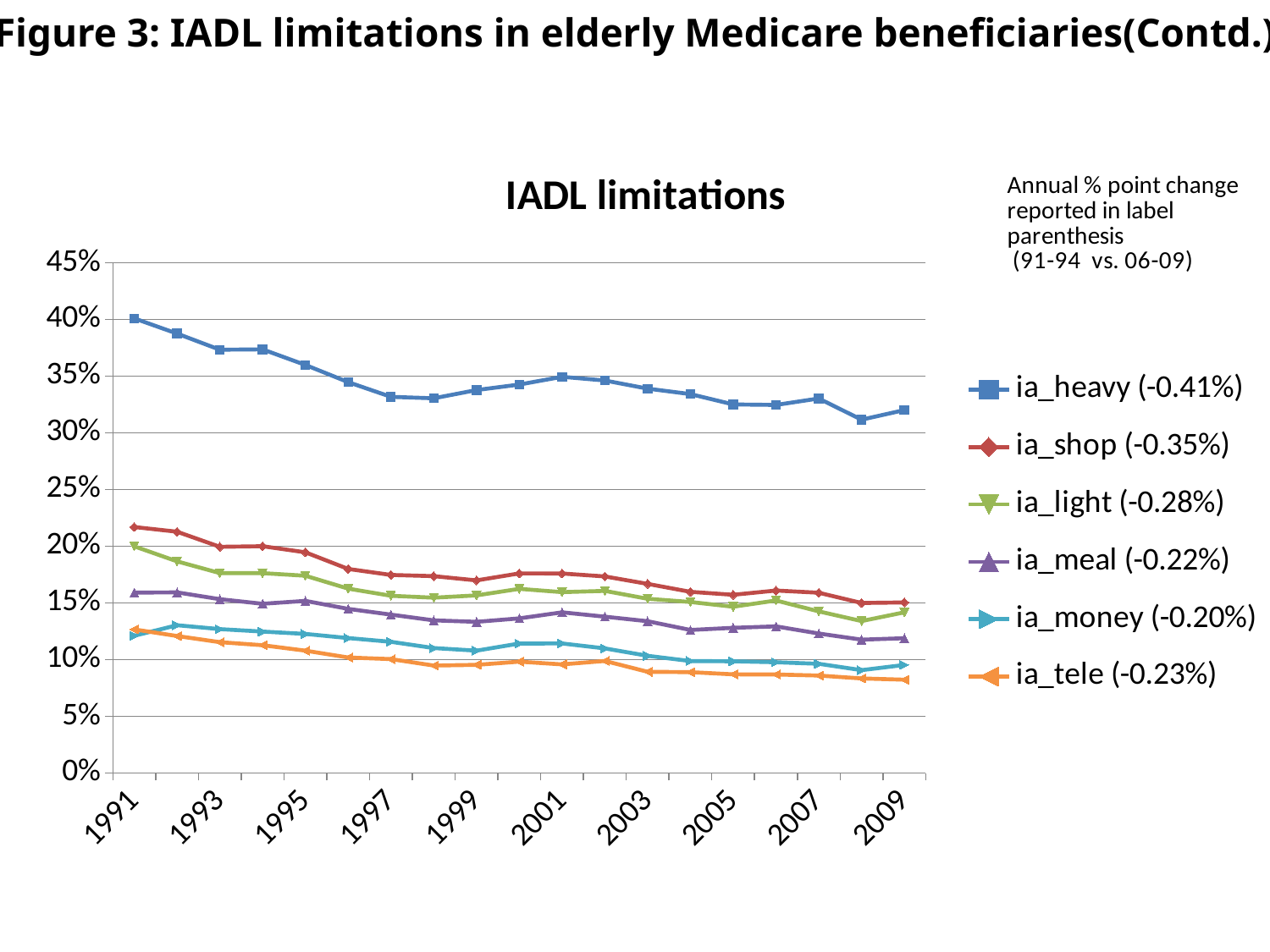
Do the values for ia_heavy generally rise or fall from 1991 to 2009? fall Is the value for ia_heavy in 1991 greater or less than 35%? greater Is the value for ia_heavy in 2009 greater or less than 35%? less How many series does the legend list? 6 Is the value for ia_shop in 1991 greater or less than 20%? greater What annual % point change is reported in the legend label for ia_heavy? -0.41% What kind of chart is shown on the slide? line chart Which series has the lowest value in 2009? ia_tele In 1991, which is larger: ia_shop or ia_light? ia_shop Which series has the highest values across all years? ia_heavy